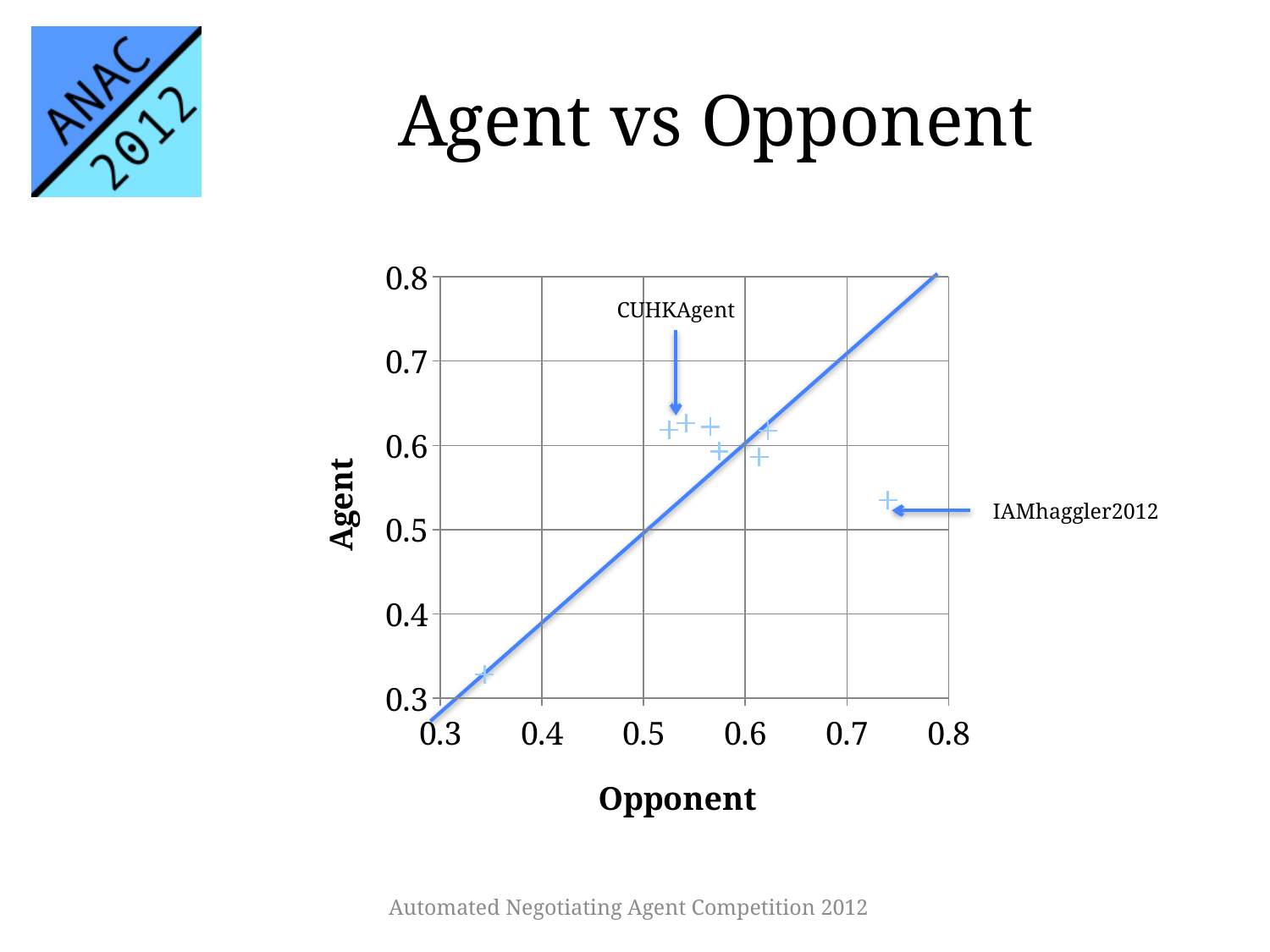
Is the Agent value for IAMhaggler2012 greater or less than 0.6? less Is the Opponent value for IAMhaggler2012 greater or less than 0.7? greater Is the Agent value for CUHKAgent greater or less than 0.6? greater Which has the higher Agent value, CUHKAgent or IAMhaggler2012? CUHKAgent What is the title of the chart? Agent vs Opponent How many data points are plotted on the chart? 8 What is the label of the horizontal axis? Opponent Which has the higher Opponent value, CUHKAgent or IAMhaggler2012? IAMhaggler2012 Of the two labelled points, which has the highest Opponent value? IAMhaggler2012 What kind of chart is shown on the slide? scatter chart